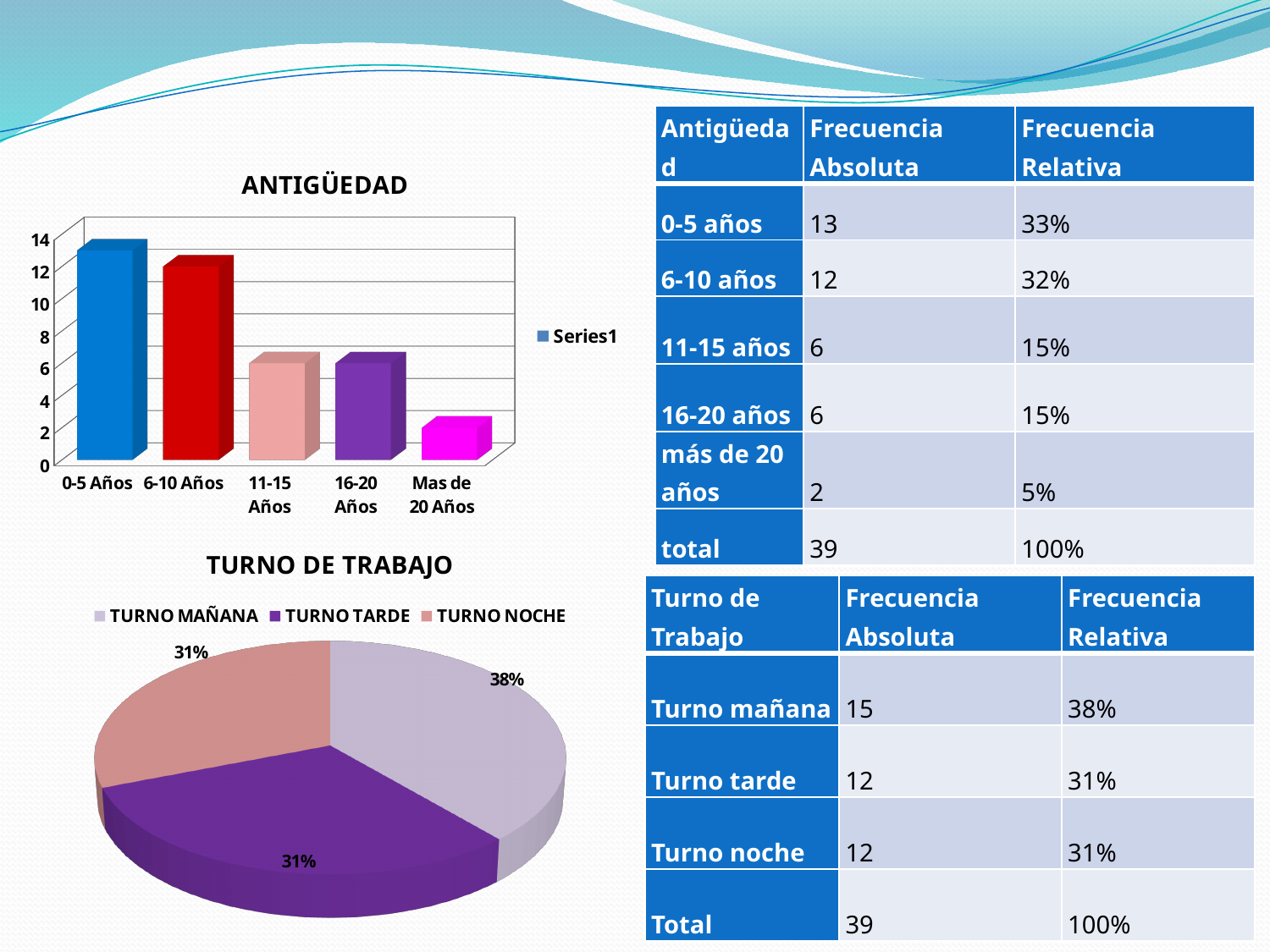
In the ANTIGÜEDAD chart, what is the value for Mas de 20 Años? 2 What kind of chart is the ANTIGÜEDAD chart? bar chart In the TURNO DE TRABAJO chart, what share of the pie is TURNO MAÑANA? 38% In the ANTIGÜEDAD chart, how many categories are shown on the x axis? 5 In the ANTIGÜEDAD chart, what is the value for 6-10 Años? 12 In the ANTIGÜEDAD chart, which category has the lowest bar? Mas de 20 Años What kind of chart is the TURNO DE TRABAJO chart? pie chart In the ANTIGÜEDAD chart, do the values generally rise or fall from left to right along the x axis? fall In the ANTIGÜEDAD chart, which category has the highest bar? 0-5 Años In the TURNO DE TRABAJO chart, how many entries does the legend list? 3 In the ANTIGÜEDAD chart, how many series does the legend list? 1 In the ANTIGÜEDAD chart, is the value for 0-5 Años greater or less than 12? greater